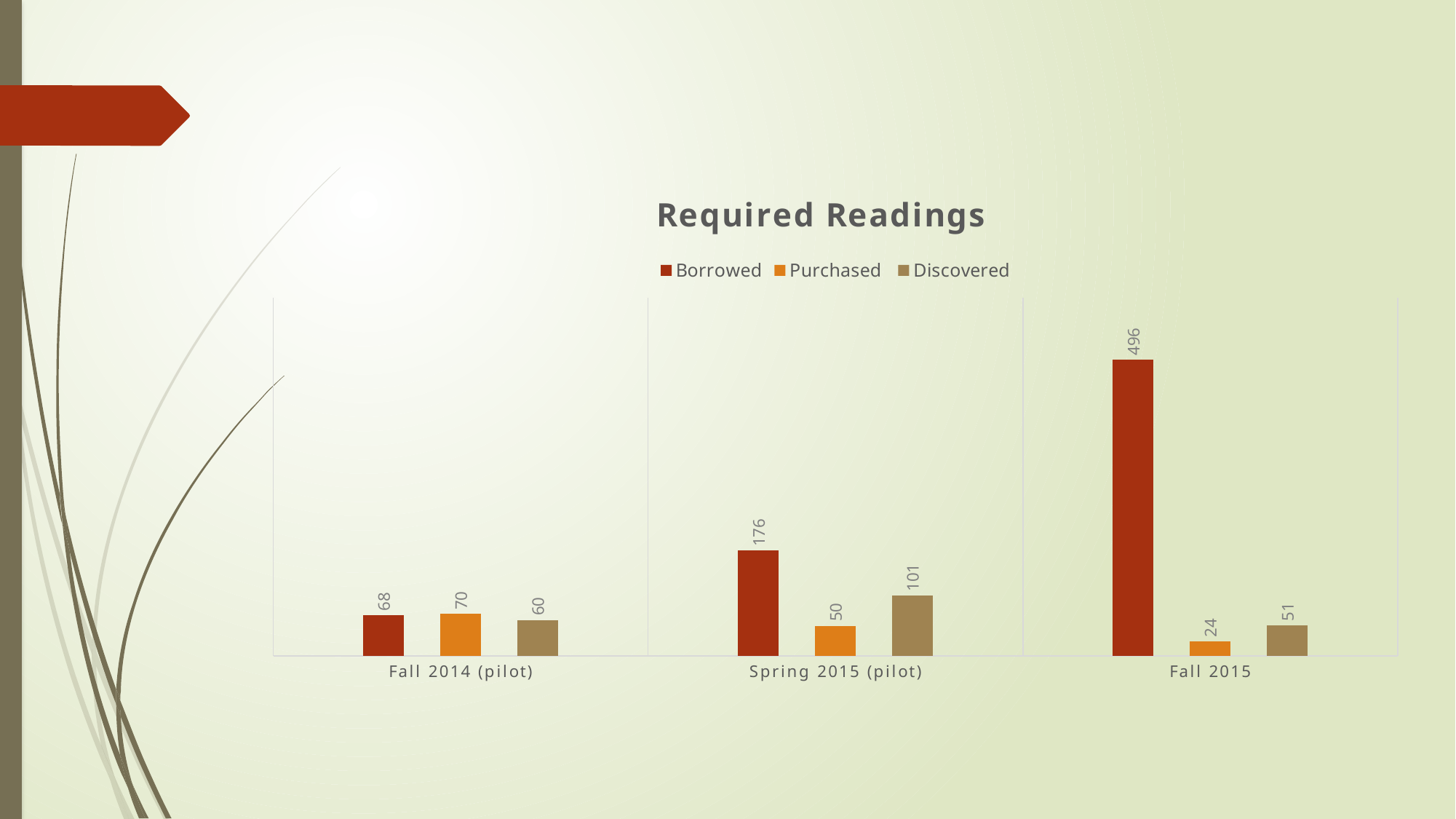
Do the Borrowed values rise or fall from Fall 2014 (pilot) to Fall 2015? rise What is the Borrowed value for Fall 2015? 496 How many categories are shown on the x axis? 3 Which category has the highest Borrowed value? Fall 2015 What is the Discovered value for Fall 2014 (pilot)? 60 What is the Purchased value for Spring 2015 (pilot)? 50 What is the title of the chart? Required Readings What kind of chart is shown? bar chart Which category has the lowest Purchased value? Fall 2015 What is the difference between the Borrowed values for Fall 2015 and Spring 2015 (pilot)? 320 How many series does the legend list? 3 Which is larger for Spring 2015 (pilot): Purchased or Discovered? Discovered